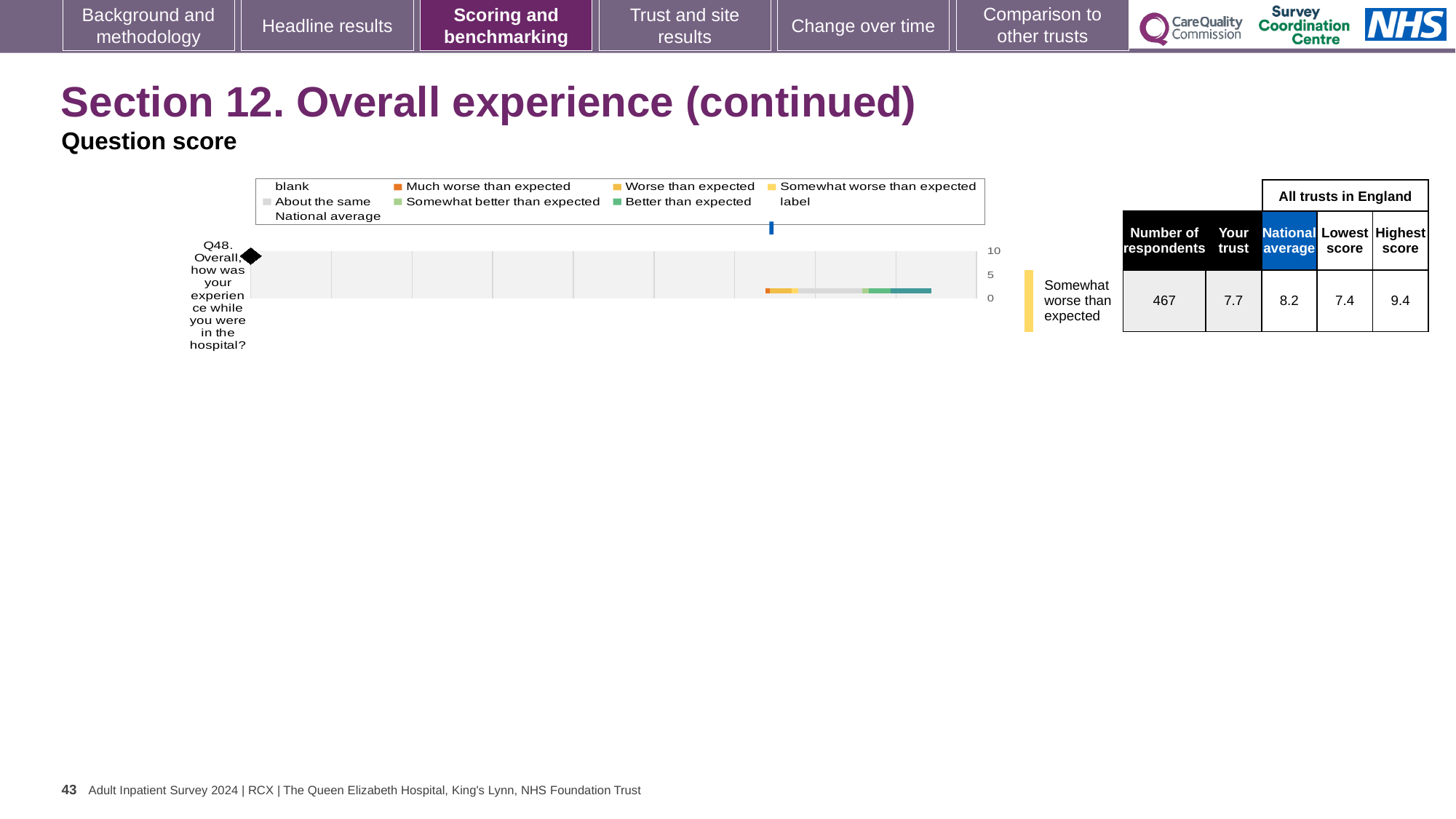
How many survey questions are plotted on the chart? 1 What is the highest score among all trusts in England for Q48? 9.4 Which is larger for Q48: the trust's score or the national average? National average Which benchmarking category is the trust's Q48 score placed in? Somewhat worse than expected What is the difference between the highest and lowest scores among all trusts in England for Q48? 2.0 What is the difference between the national average and the trust's score for Q48? 0.5 What is the maximum value shown on the chart's score axis? 10 How many respondents answered Q48? 467 What is the lowest score among all trusts in England for Q48? 7.4 What is the national average score for Q48? 8.2 What is the 'Your trust' score for Q48 (Overall, how was your experience while you were in the hospital?)? 7.7 What kind of chart is shown on the slide? bar chart